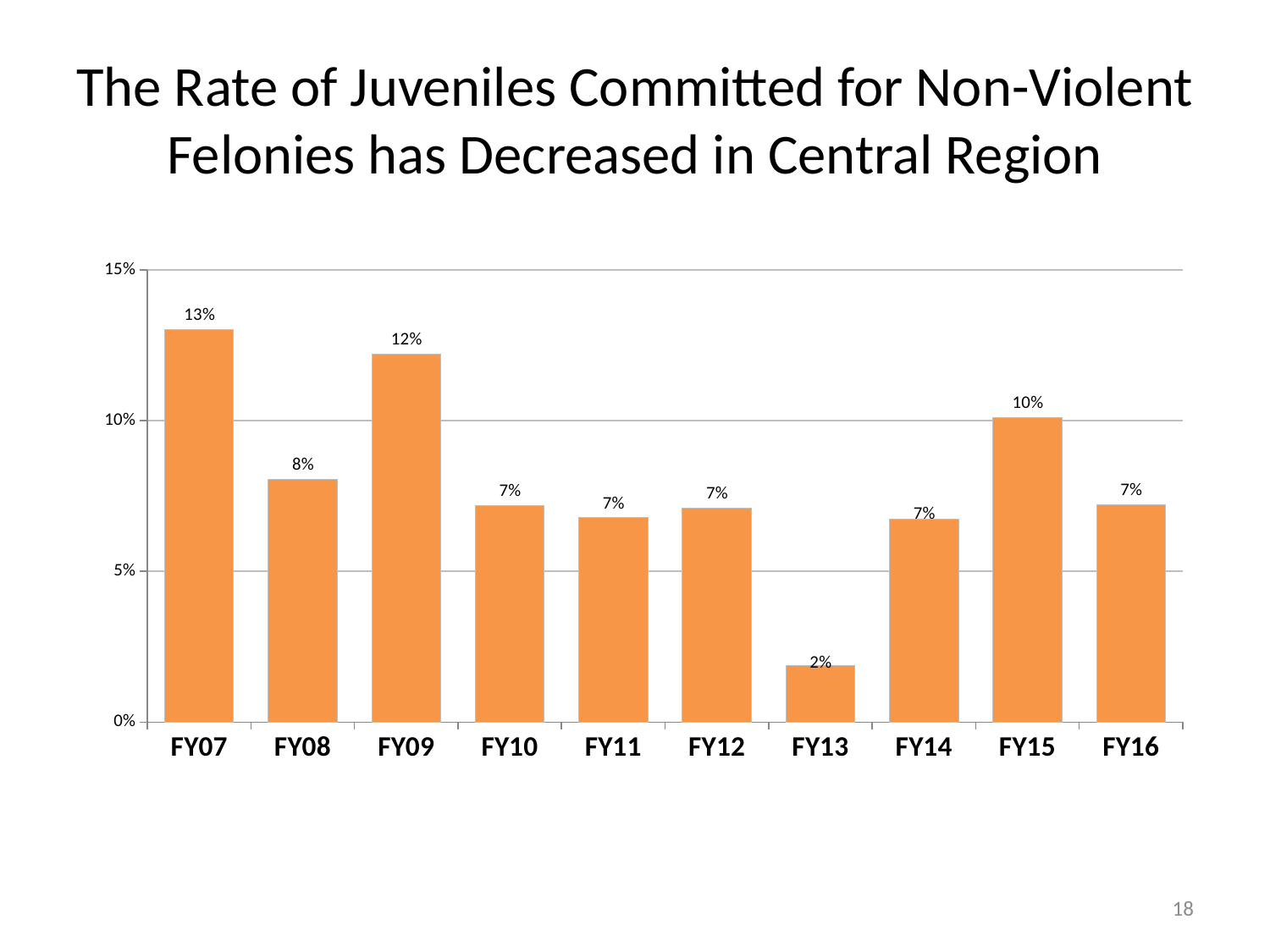
What is the value for FY07? 13% What kind of chart is shown on the slide? Bar chart Is the value for FY09 greater or less than 10%? greater What is the difference between the values for FY07 and FY13? 11% Which fiscal year has the lowest value? FY13 Which is larger, the value for FY08 or the value for FY15? FY15 What is the value for FY15? 10% How many fiscal years are shown on the x axis? 10 What is the value for FY09? 12% What colour are the bars in the chart? Orange Which fiscal year has the highest value? FY07 What is the value for FY13? 2%